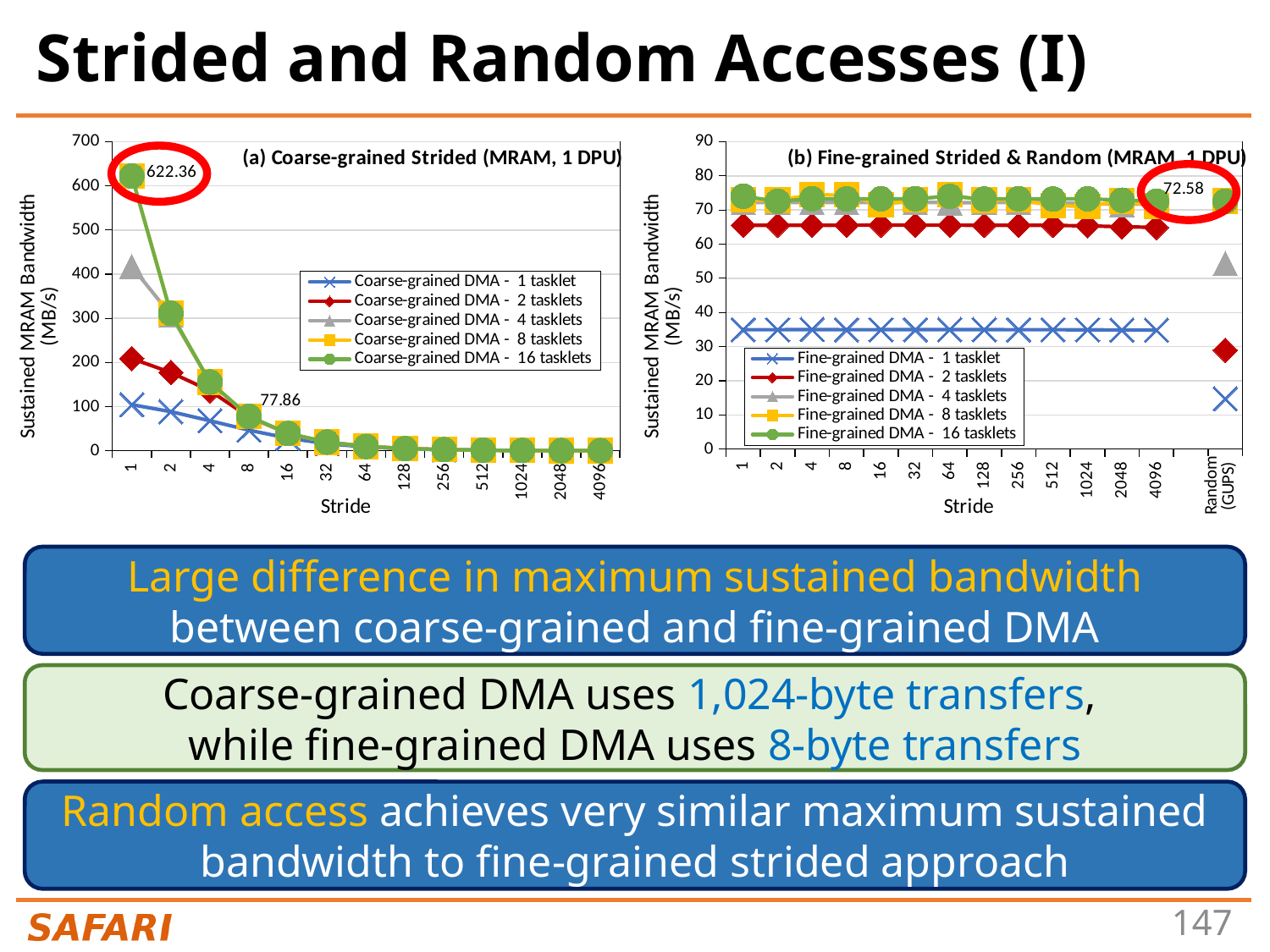
In chart (b) Fine-grained Strided & Random (MRAM, 1 DPU), is the value for Fine-grained DMA - 1 tasklet at stride 1 greater or less than 40? less In chart (a) Coarse-grained Strided (MRAM, 1 DPU), how many stride values are on the x axis? 13 In chart (a) Coarse-grained Strided (MRAM, 1 DPU), how many series does the legend list? 5 In chart (b) Fine-grained Strided & Random (MRAM, 1 DPU), how many categories are on the x axis? 14 What kind of chart is chart (a) Coarse-grained Strided (MRAM, 1 DPU)? line chart In chart (a) Coarse-grained Strided (MRAM, 1 DPU), do the values for Coarse-grained DMA - 16 tasklets rise or fall as the stride increases? fall In chart (a) Coarse-grained Strided (MRAM, 1 DPU), at which stride is the value for Coarse-grained DMA - 16 tasklets highest? 1 In chart (b) Fine-grained Strided & Random (MRAM, 1 DPU), at Random (GUPS), which is larger: Fine-grained DMA - 4 tasklets or Fine-grained DMA - 1 tasklet? Fine-grained DMA - 4 tasklets In chart (a) Coarse-grained Strided (MRAM, 1 DPU), is the value for Coarse-grained DMA - 4 tasklets at stride 1 greater or less than 300? greater In chart (a) Coarse-grained Strided (MRAM, 1 DPU), what is the labeled value at stride 1 for Coarse-grained DMA - 16 tasklets? 622.36 In chart (b) Fine-grained Strided & Random (MRAM, 1 DPU), what is the labeled value for Fine-grained DMA - 16 tasklets at Random (GUPS)? 72.58 What is the y-axis title of chart (b) Fine-grained Strided & Random (MRAM, 1 DPU)? Sustained MRAM Bandwidth (MB/s)